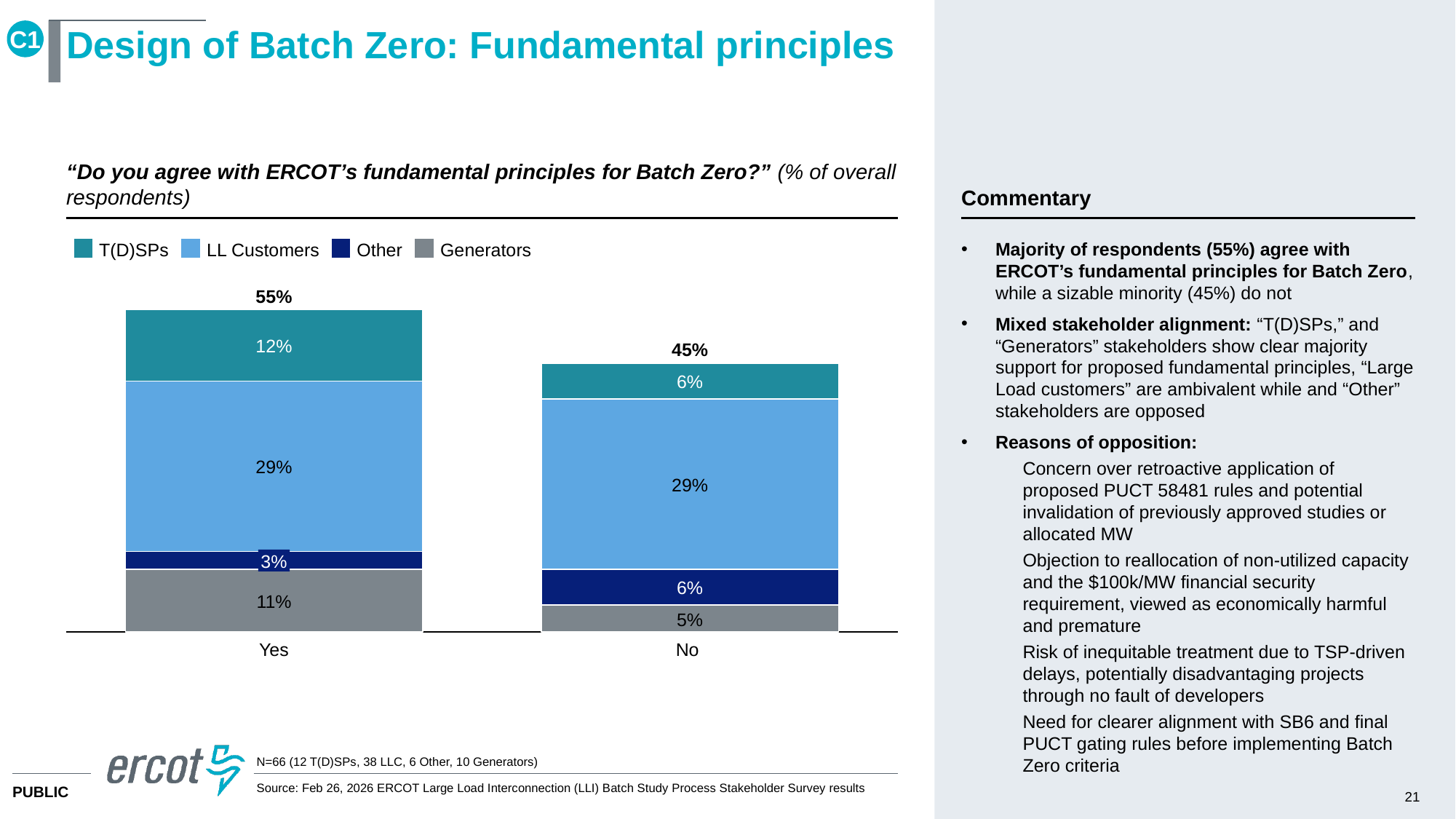
Which bar has the higher total, Yes or No? Yes What is the LL Customers value in the No bar? 29% What is the Generators value in the Yes bar? 11% What is the total of the Yes bar? 55% How many series does the legend list? 4 What is the Other value in the No bar? 6% What is the difference between the Generators values for Yes and No? 6% What is the total of the No bar? 45% How many categories are shown on the x axis? 2 What kind of chart is shown? Stacked bar chart What is the difference between the T(D)SPs values for Yes and No? 6% What is the T(D)SPs value in the Yes bar? 12%